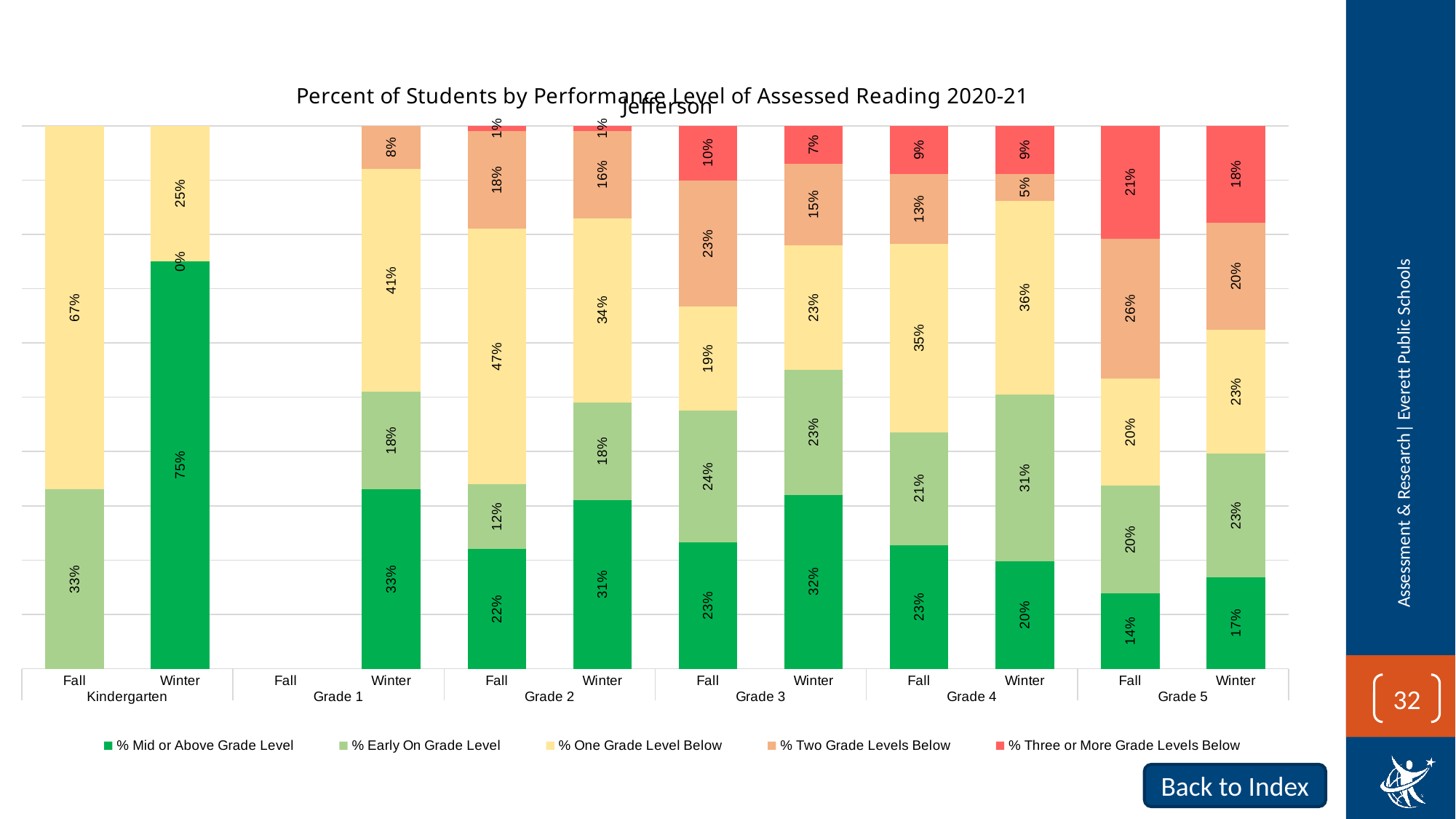
What is the % One Grade Level Below value for Grade 2 Fall? 47% Which bar has the highest % Mid or Above Grade Level value? Kindergarten Winter What colour represents % Three or More Grade Levels Below in the legend? red What is the % Two Grade Levels Below value for Grade 4 Winter? 5% What kind of chart is shown on the slide? stacked bar chart Which is larger: the % Early On Grade Level value for Grade 4 Winter or for Grade 4 Fall? Grade 4 Winter What is the % Mid or Above Grade Level value for Kindergarten Winter? 75% How many series does the legend list? 5 What is the % Three or More Grade Levels Below value for Grade 5 Fall? 21% Which bar has the lowest % Mid or Above Grade Level value? Kindergarten Fall Which grade and term has no bar plotted on the chart? Grade 1 Fall What is the difference between the % Mid or Above Grade Level values for Grade 3 Winter and Grade 3 Fall? 9%